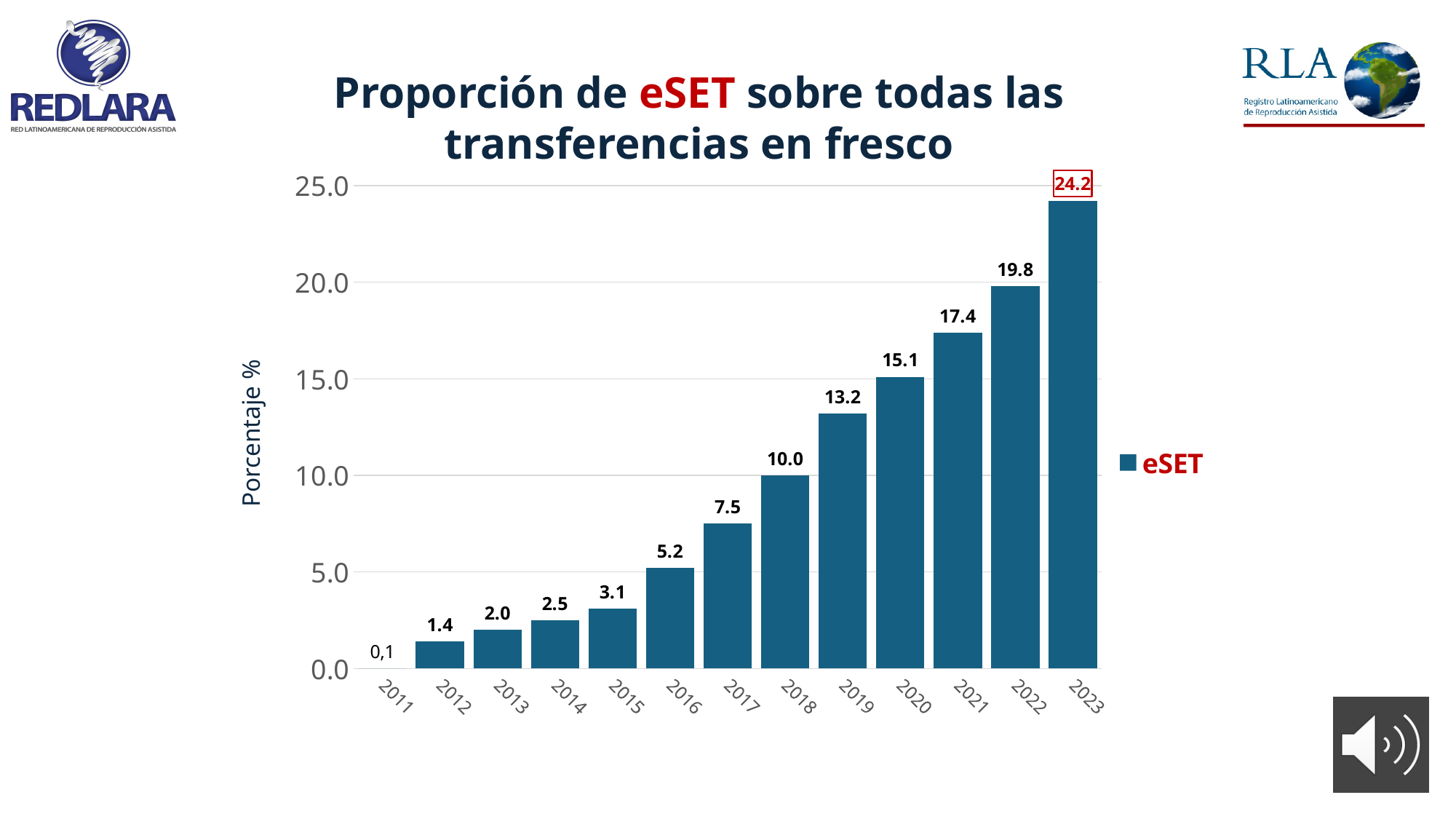
What is the value for 2023? 24.2 What is the value for 2011? 0,1 Is the value for 2021 greater or less than 15.0? greater Do the values rise or fall from 2011 to 2023? rise How many years are shown on the x axis? 13 What kind of chart is shown? bar chart Which year has the highest value? 2023 What is the difference between the values for 2023 and 2022? 4.4 Which is larger, the value for 2017 or the value for 2020? 2020 What is the value for 2018? 10.0 What is the difference between the values for 2019 and 2016? 8.0 Which year has the lowest value? 2011